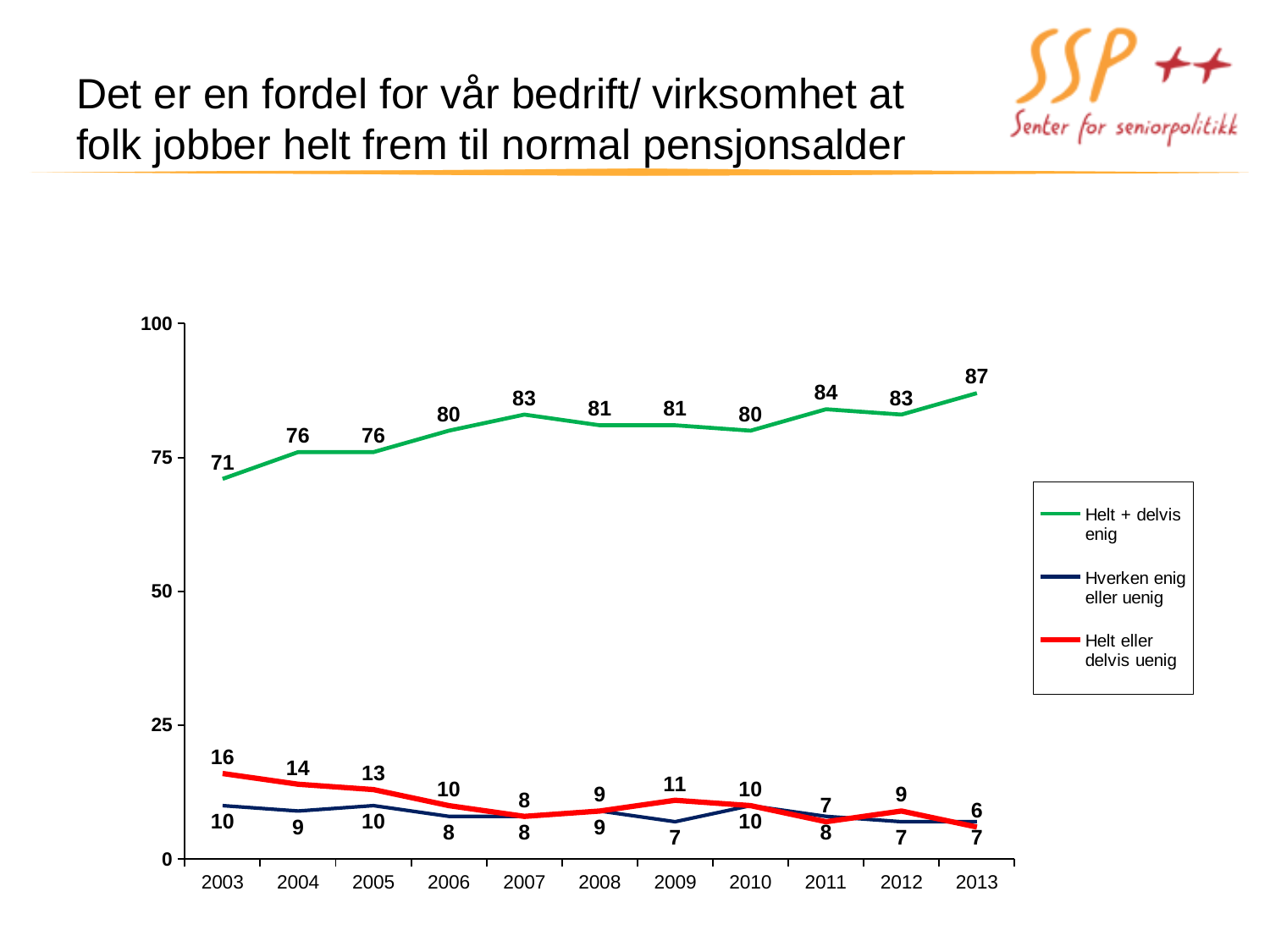
In which year is the "Helt + delvis enig" series at its lowest? 2003 What is the value for "Helt eller delvis uenig" in 2003? 16 What is the difference between the "Helt + delvis enig" values in 2013 and 2003? 16 What is the value for "Hverken enig eller uenig" in 2009? 7 Does the "Helt eller delvis uenig" series generally rise or fall from 2003 to 2013? fall How many series does the legend list? 3 Which is larger in 2012: "Helt eller delvis uenig" or "Hverken enig eller uenig"? Helt eller delvis uenig In which year is the "Helt + delvis enig" series at its highest? 2013 What is the value for "Helt + delvis enig" in 2013? 87 Is the value for "Helt + delvis enig" in 2007 greater or less than 75? greater What kind of chart is shown on the slide? line chart How many years are shown on the x axis? 11